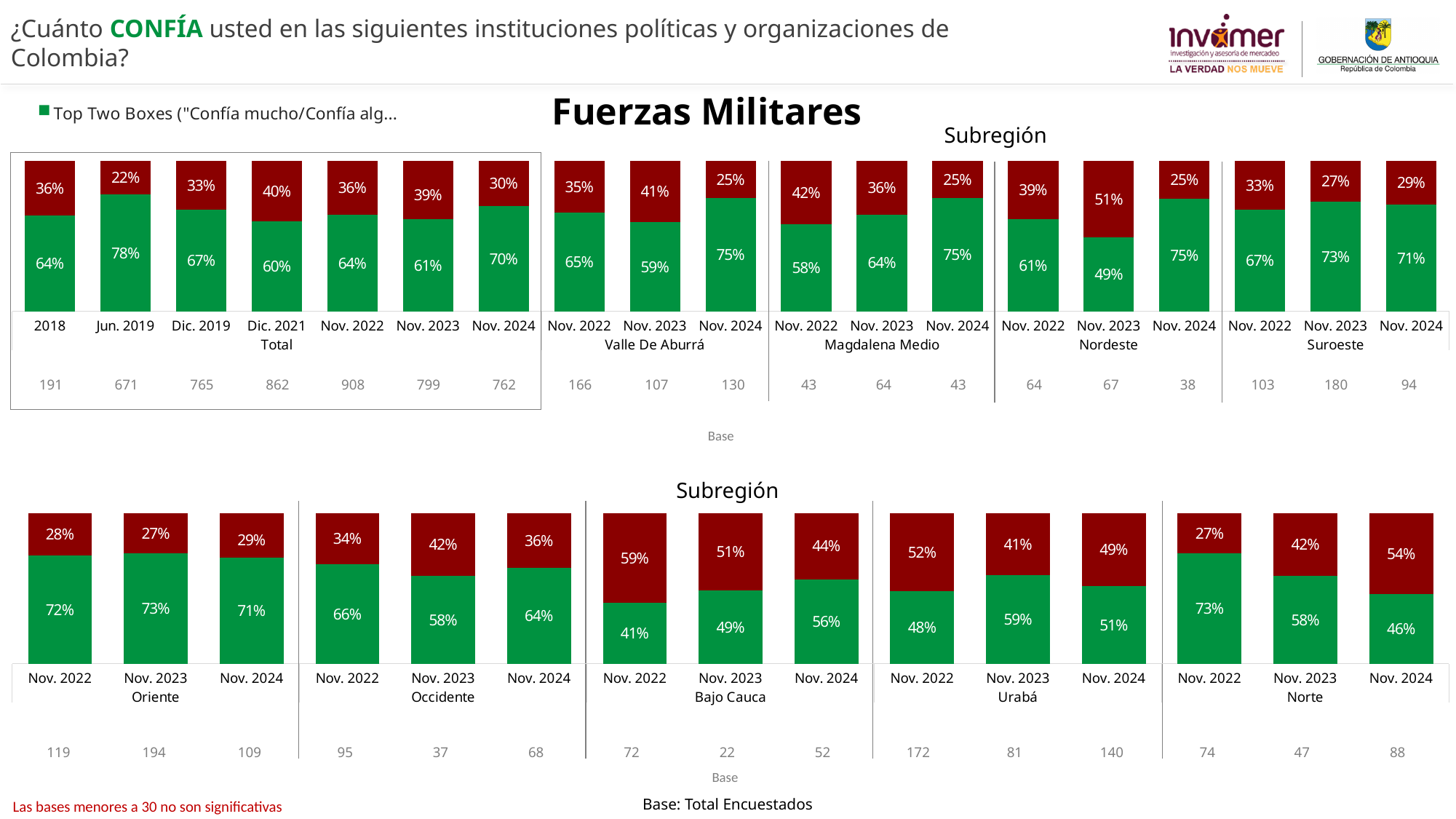
In the top chart, how many bars are shown for the Total group? 7 In the top chart, which Total period has the highest green Top Two Boxes value? Jun. 2019 In the bottom chart, what is the red segment value for Norte in Nov. 2024? 54% In the bottom chart, do the green Top Two Boxes values for Norte rise or fall from Nov. 2022 to Nov. 2024? Fall In the top chart, what is the difference between the green values for Total in Jun. 2019 and Dic. 2021? 18 percentage points What is the main title of the chart on the slide? Fuerzas Militares What type of chart is used on this slide? Stacked bar chart In the top chart, what is the green Top Two Boxes value for Nordeste in Nov. 2023? 49% In the bottom chart, which Bajo Cauca period has the lowest green Top Two Boxes value? Nov. 2022 In the bottom chart, which is larger: the green value for Oriente in Nov. 2022 or for Occidente in Nov. 2022? Oriente in Nov. 2022 In the top chart, what is the total of the stacked bar for Suroeste in Nov. 2023? 100% In the top chart, what is the green Top Two Boxes value for Total in Nov. 2024? 70%